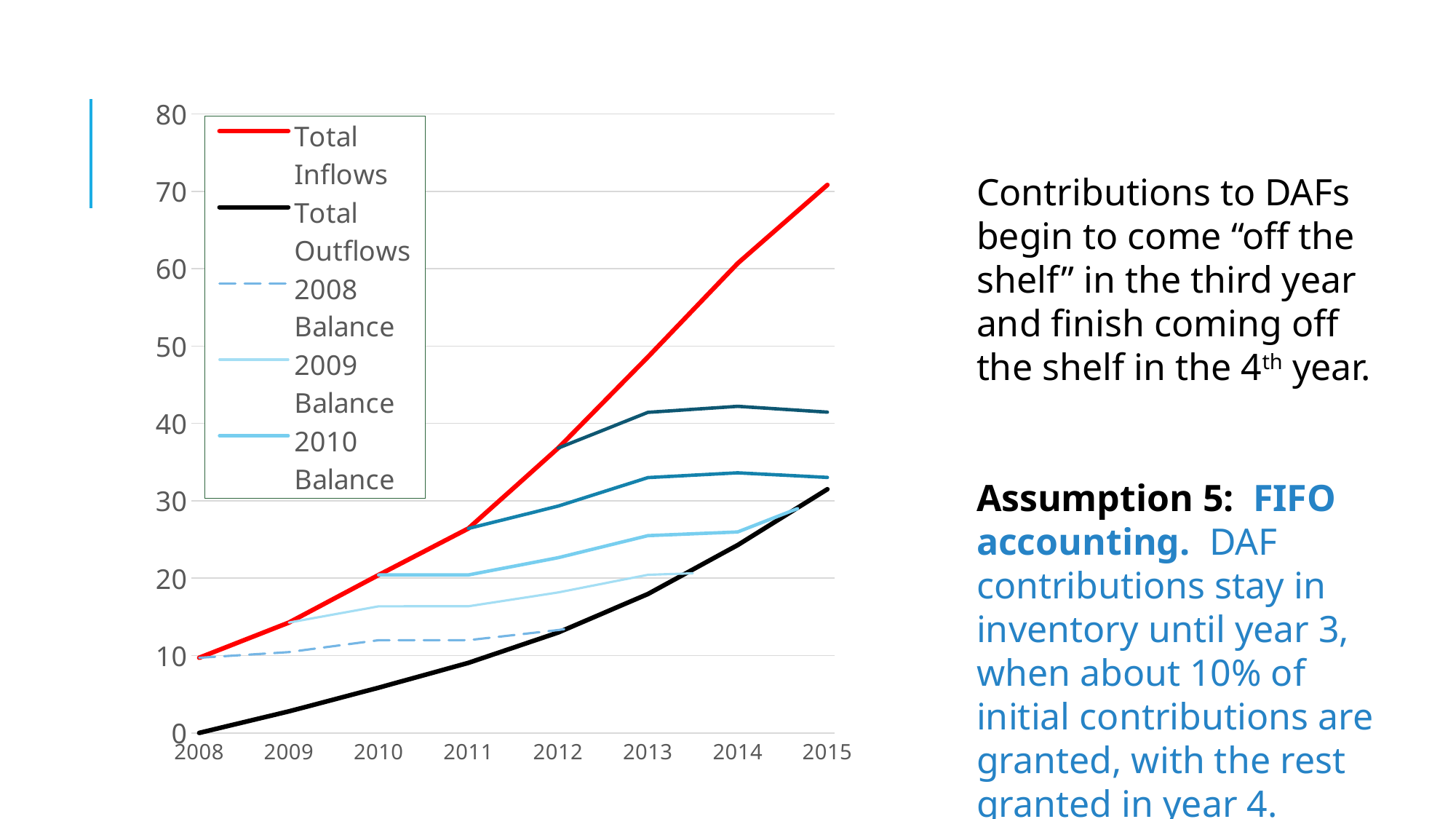
Do the values of Total Inflows rise or fall from 2008 to 2015? rise Which series has the highest value in 2015? Total Inflows Is the value of Total Outflows in 2013 greater or less than 20? less How many years are shown along the x axis of the chart? 8 Which is larger in 2015, Total Inflows or Total Outflows? Total Inflows Is the value of the 2010 Balance in 2013 greater or less than 20? greater How many series does the chart's legend list? 5 Is the value of Total Inflows in 2013 greater or less than 50? less Which legend entry is drawn with a dashed line? 2008 Balance What kind of chart is shown on the slide? line chart